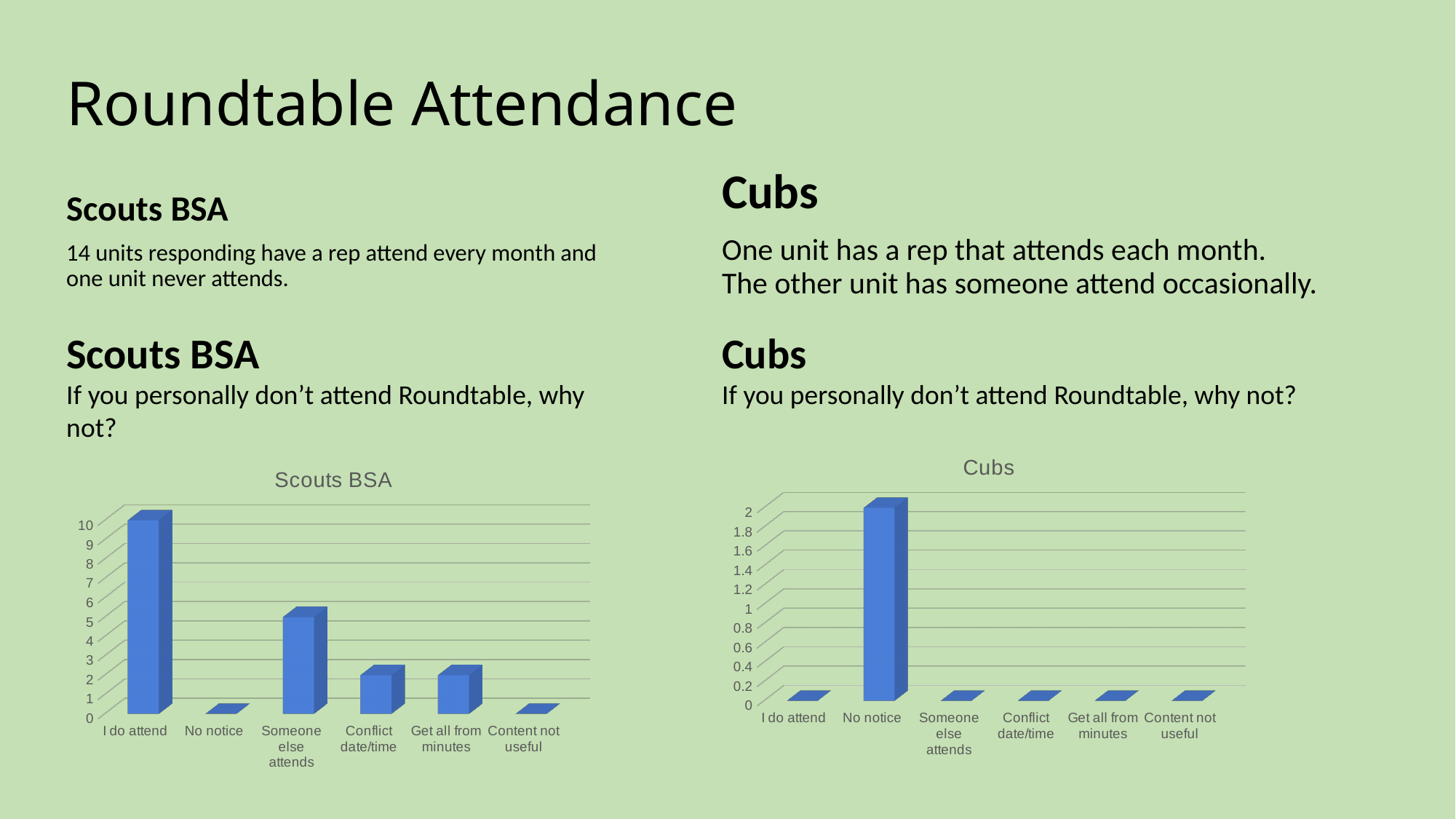
In the Scouts BSA chart, what is the value for "Someone else attends"? 5 What kind of chart is the Scouts BSA chart? bar chart In the Cubs chart, what is the value for "I do attend"? 0 In the Cubs chart, which category has the highest value? No notice In the Scouts BSA chart, is the value for "Conflict date/time" greater or less than 5? less In the Cubs chart, what is the value for "No notice"? 2 What is the title of the chart on the right side of the slide? Cubs In the Scouts BSA chart, what is the value for "I do attend"? 10 In the Scouts BSA chart, which category has the highest value? I do attend How many categories are shown on the x axis of the Cubs chart? 6 In the Scouts BSA chart, which is larger, the value for "Someone else attends" or the value for "Conflict date/time"? Someone else attends In the Scouts BSA chart, what is the difference between the values for "I do attend" and "Someone else attends"? 5